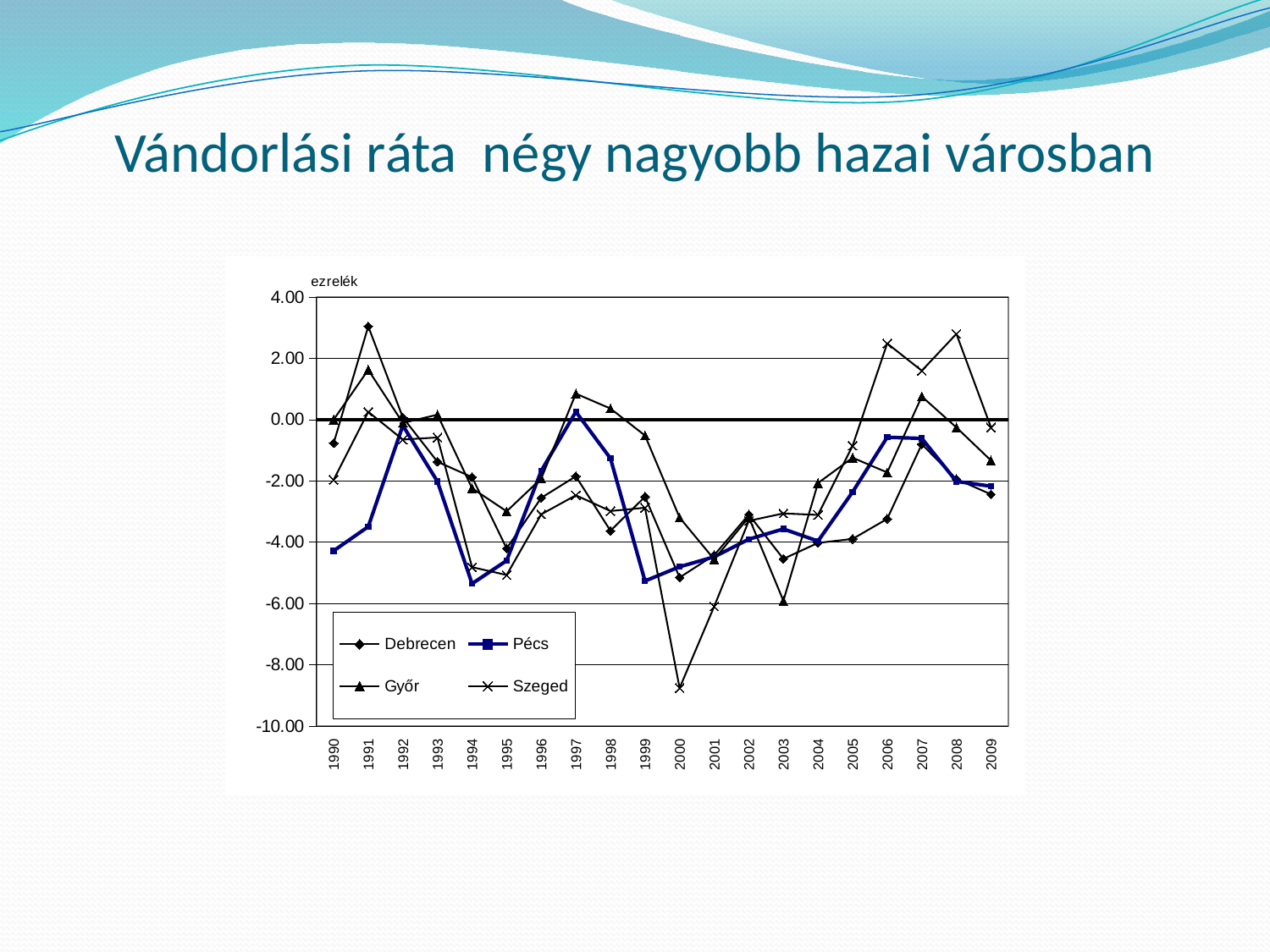
Does the value for Győr rise or fall from 1997 to 2000? fall How many series does the legend list? 4 Which is larger in 2003, the value for Debrecen or the value for Győr? Debrecen What kind of chart is shown on the slide? line chart Which city has the lowest value in 2000? Szeged What unit label is printed above the y axis? ezrelék Is the value for Debrecen in 1991 greater or less than 2.00? greater What is the title of the slide containing the chart? Vándorlási ráta négy nagyobb hazai városban How many years are shown along the x axis? 20 Is the value for Szeged in 2000 greater or less than -8.00? less Which city has the highest value in 2006? Szeged Which city has the highest value in 1991? Debrecen